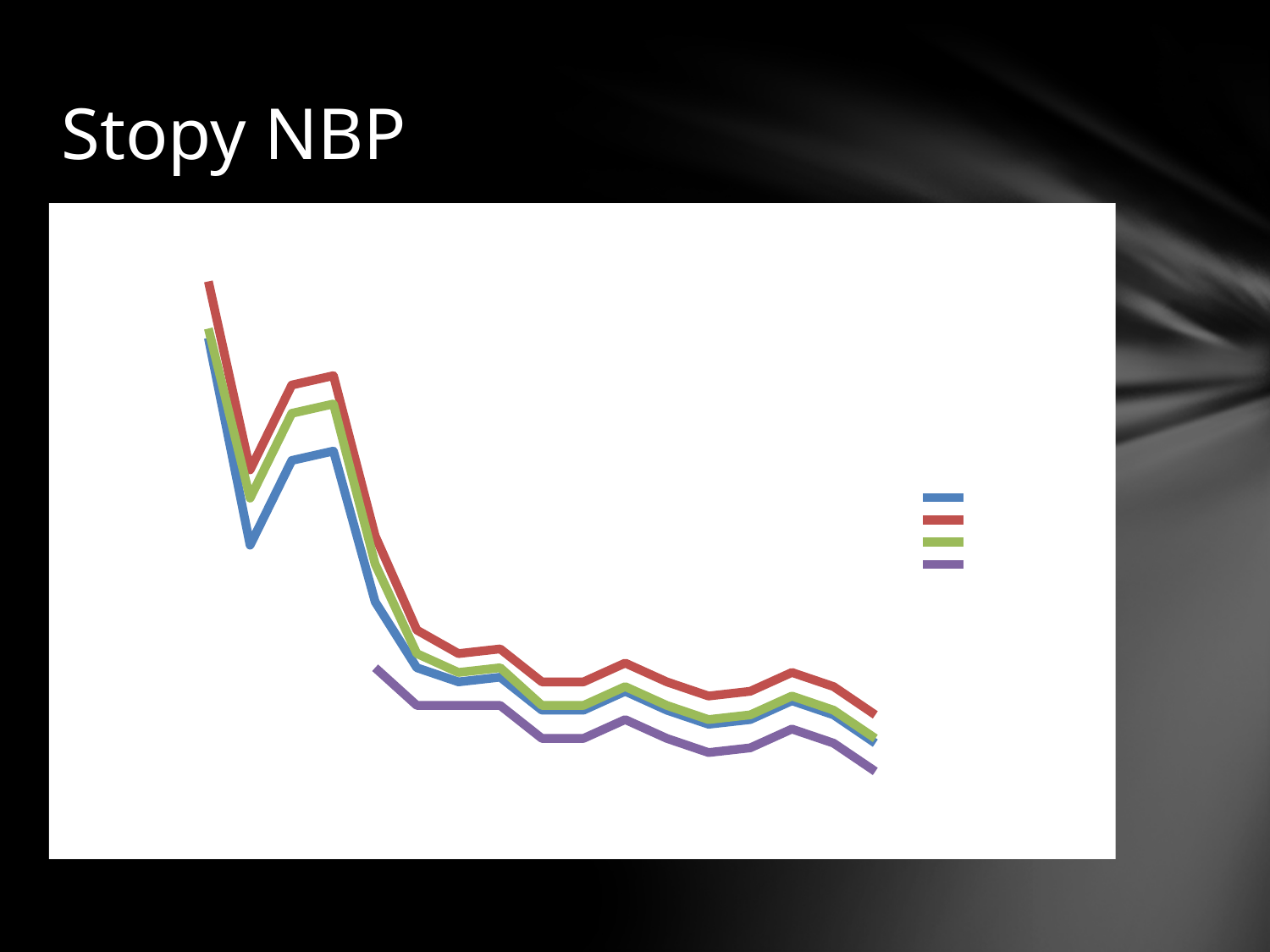
At the right end of the chart, is the red line above or below the blue line? above Do the plotted values generally rise or fall from left to right along the x axis? fall What kind of chart is shown on the slide? line chart Which coloured line stays highest across the chart? red Which coloured line stays lowest across the chart? purple How many series does the legend list? 4 At the right end of the chart, is the purple line above or below the green line? below